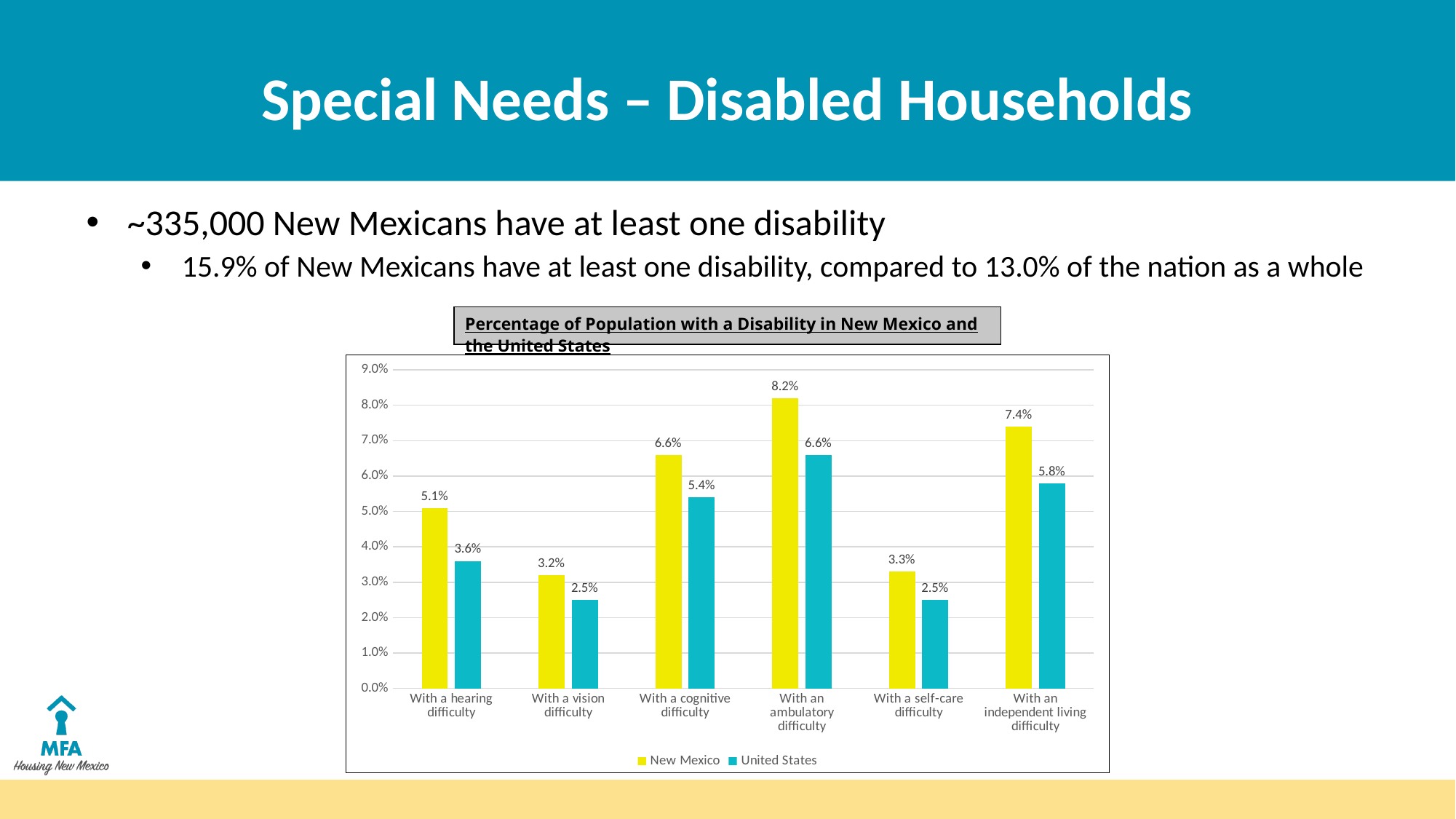
Which category has the lowest United States value? With a vision difficulty and With a self-care difficulty (both 2.5%) What kind of chart is shown on the slide? Bar chart Which is larger for 'With a cognitive difficulty': the New Mexico value or the United States value? New Mexico Which category has the highest New Mexico value? With an ambulatory difficulty What is the New Mexico value for 'With a hearing difficulty'? 5.1% What is the United States value for 'With a vision difficulty'? 2.5% Which colour represents the United States series in the chart? Blue (teal) What is the United States value for 'With an independent living difficulty'? 5.8% What is the difference between the New Mexico and United States values for 'With an ambulatory difficulty'? 1.6% How many categories are shown on the x axis? 6 What is the title of the chart? Percentage of Population with a Disability in New Mexico and the United States How many series does the legend list? 2